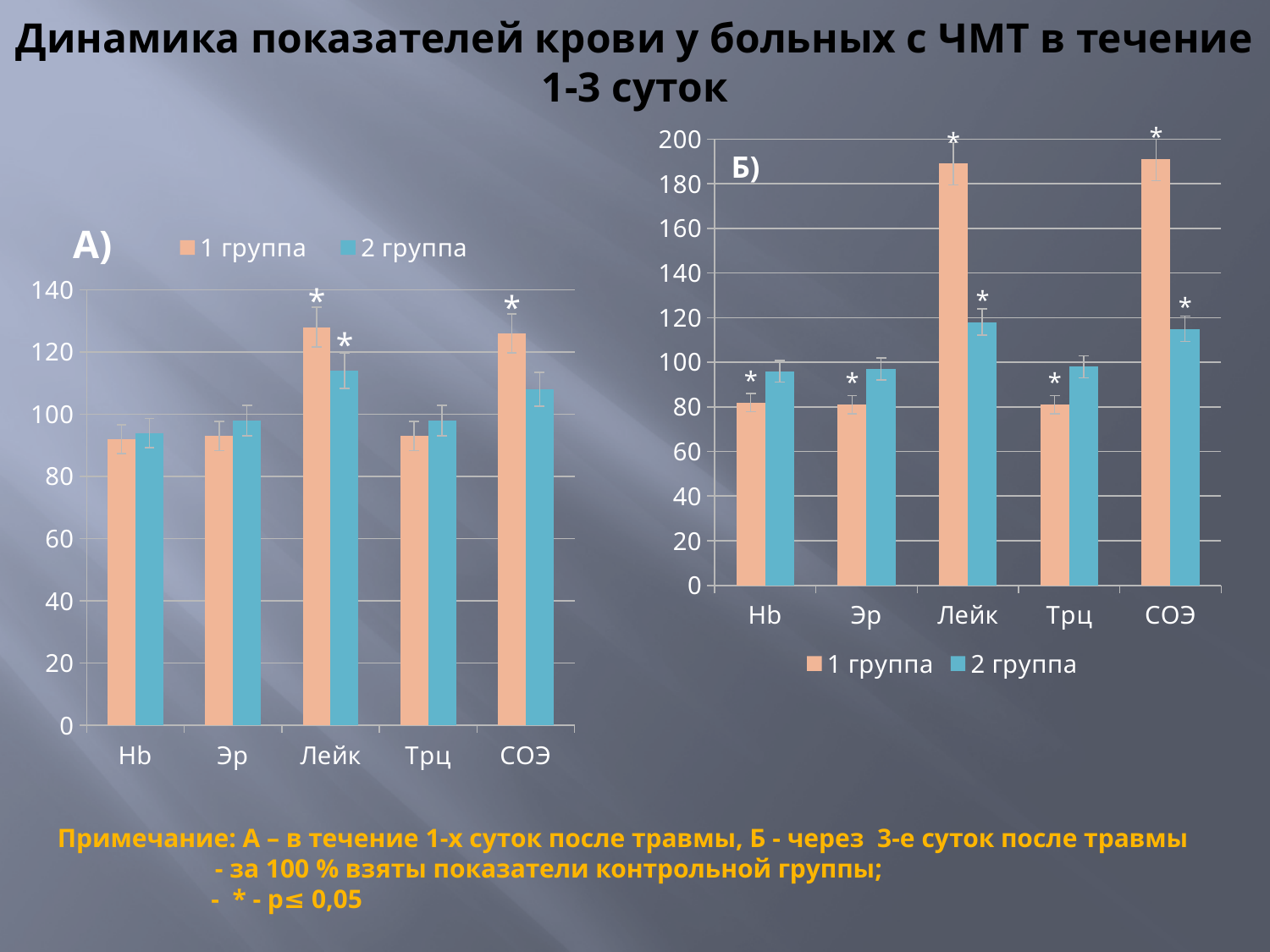
In chart Б), is the value for СОЭ in series 2 группа greater or less than 140? less In chart Б), is the value for Hb in series 1 группа greater or less than 100? less What kind of chart is chart А) on the left of the slide? bar chart In chart А), is the value for Лейк in series 2 группа greater or less than 100? greater In chart Б), which is larger for Hb: the value for 1 группа or for 2 группа? 2 группа What are the two legend entries of chart Б)? 1 группа, 2 группа Which chart has a y axis that goes up to 200: А) or Б)? Б) How many categories are shown on the x axis of chart Б)? 5 In chart Б), which is larger for Лейк: the value for 1 группа or for 2 группа? 1 группа How many series does the legend of chart А) list? 2